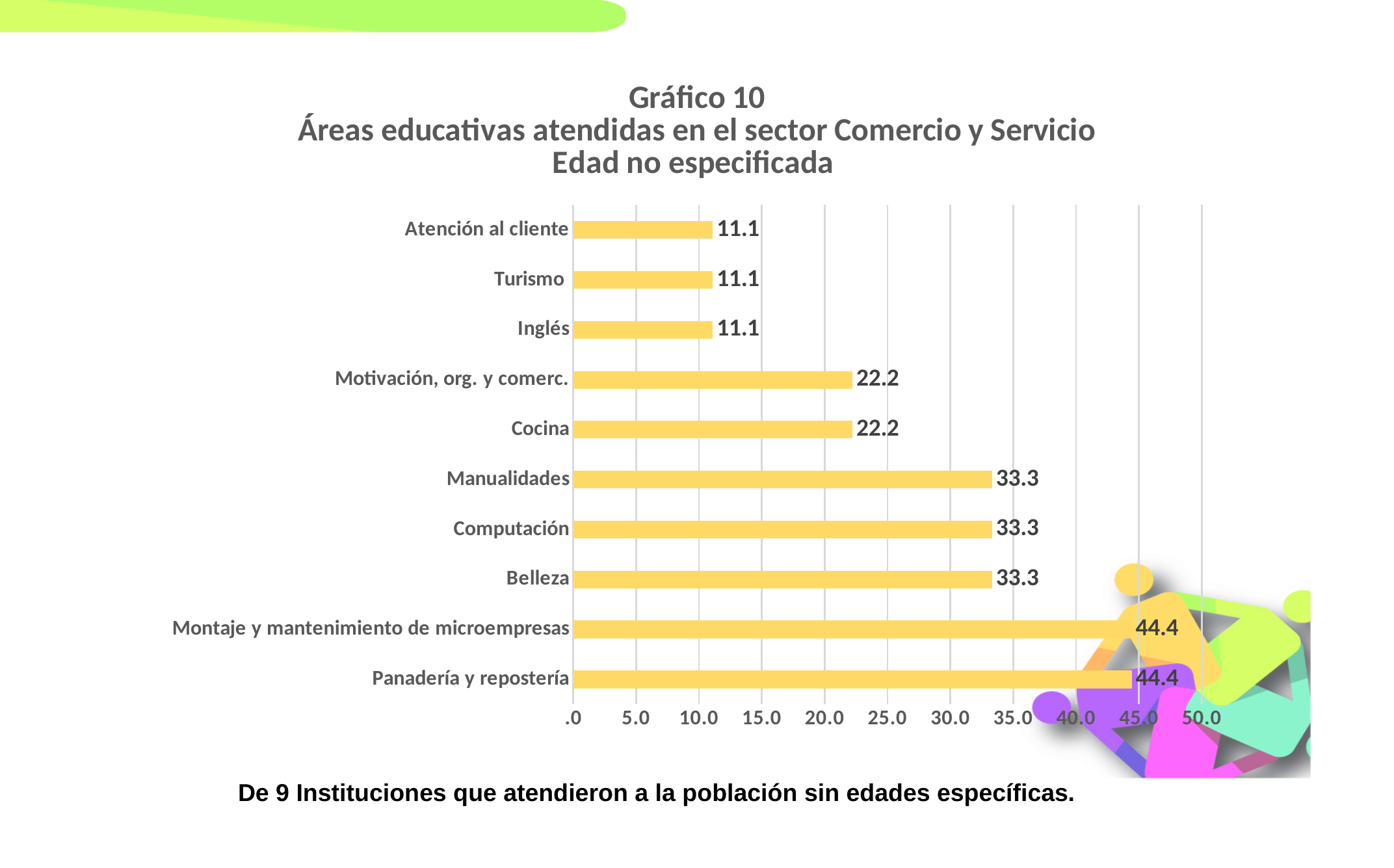
What is the difference between the values for Belleza and Motivación, org. y comerc.? 11.1 What is the title of the chart? Gráfico 10 Áreas educativas atendidas en el sector Comercio y Servicio Edad no especificada How many categories are shown in the chart? 10 What is the value for Turismo? 11.1 What is the value for Montaje y mantenimiento de microempresas? 44.4 What is the value for Cocina? 22.2 What colour are the bars in the chart? yellow Which is larger, the value for Manualidades or the value for Atención al cliente? Manualidades Is the value for Cocina greater or less than 20.0? greater What is the difference between the values for Panadería y repostería and Inglés? 33.3 What is the value for Computación? 33.3 What kind of chart is shown on the slide? bar chart